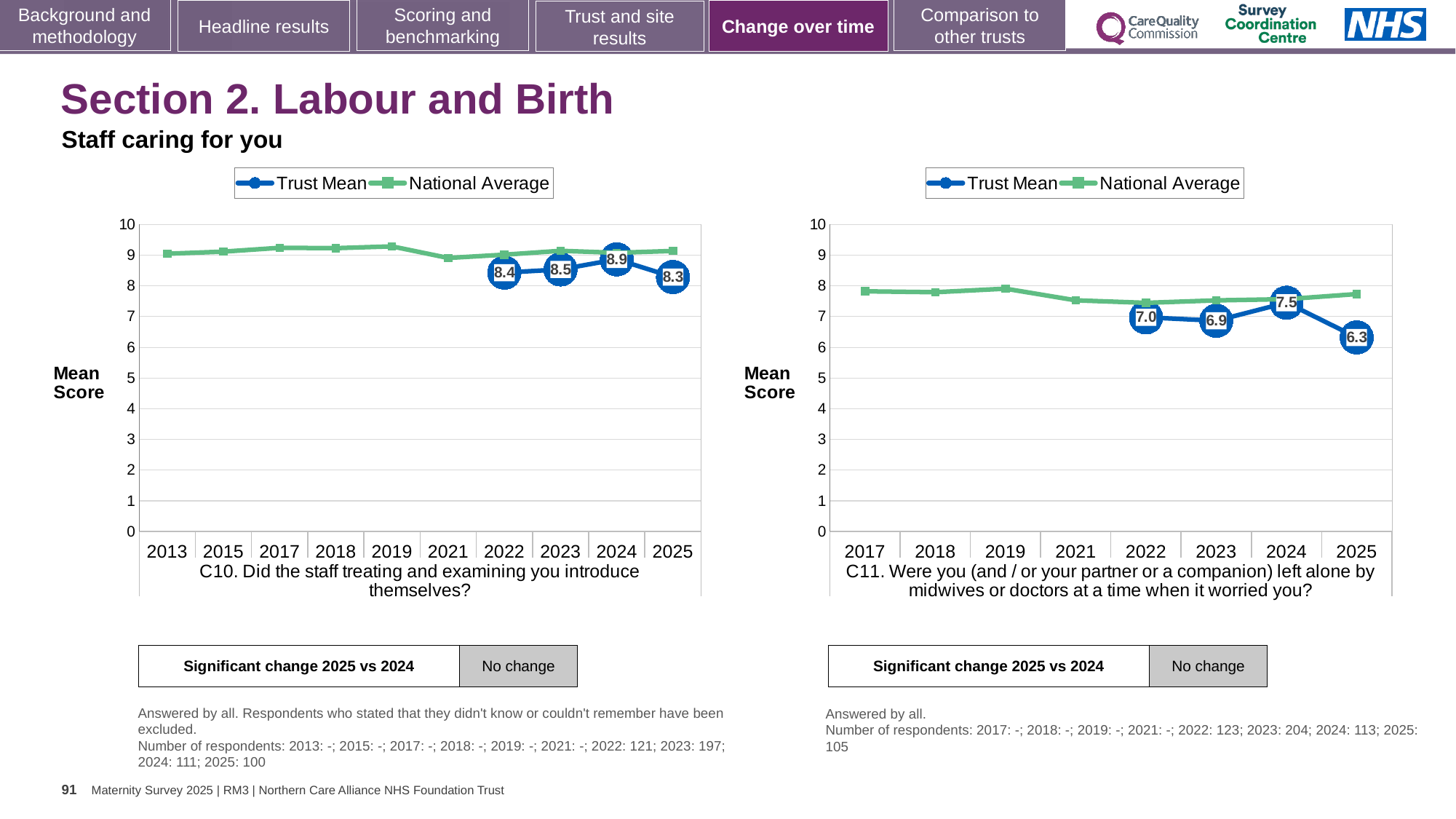
In the C10 chart (left), what is the Trust Mean value for 2025? 8.3 In the C10 chart (left), what is the difference between the Trust Mean values for 2024 and 2025? 0.6 In the C10 chart (left), which year has the highest labelled Trust Mean value? 2024 In the C11 chart (right), which year has the lowest labelled Trust Mean value? 2025 In the C11 chart (right), what is the Trust Mean value for 2022? 7.0 In the C10 chart (left), what is the Trust Mean value for 2024? 8.9 How many series does the legend of the C11 chart (right) list? 2 In the C10 chart (left), is the National Average value for 2013 greater or less than 8? greater In the C10 chart (left), how many years are shown on the x axis? 10 What type of chart is the C10 chart (left)? line chart In the C11 chart (right), does the Trust Mean rise or fall from 2024 to 2025? fall In the C11 chart (right), which is larger, the Trust Mean for 2023 or for 2024? 2024